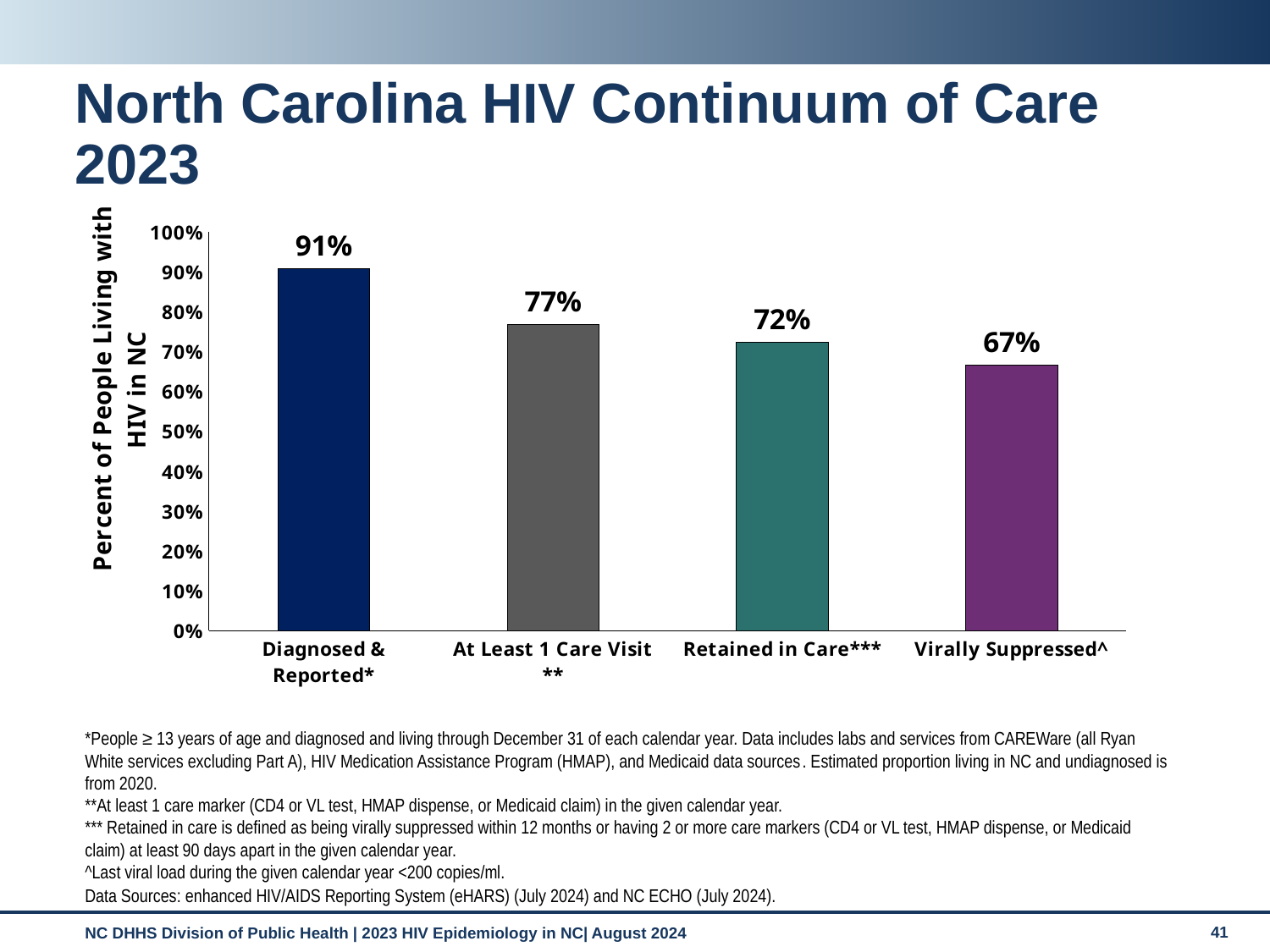
What is the difference between the Diagnosed & Reported value and the Virally Suppressed value? 24% What is the value for Virally Suppressed? 67% Do the values rise or fall moving from left to right along the x axis? Fall How many categories are shown on the x axis? 4 What is the value for At Least 1 Care Visit? 77% What is the value for Retained in Care? 72% Which stage of the continuum has the highest percentage? Diagnosed & Reported What is the difference between At Least 1 Care Visit and Retained in Care? 5% What type of chart is shown on the slide? Bar chart What percent of people living with HIV in NC were Diagnosed & Reported? 91% Which is larger, the value for Retained in Care or the value for Virally Suppressed? Retained in Care Which stage of the continuum has the lowest percentage? Virally Suppressed